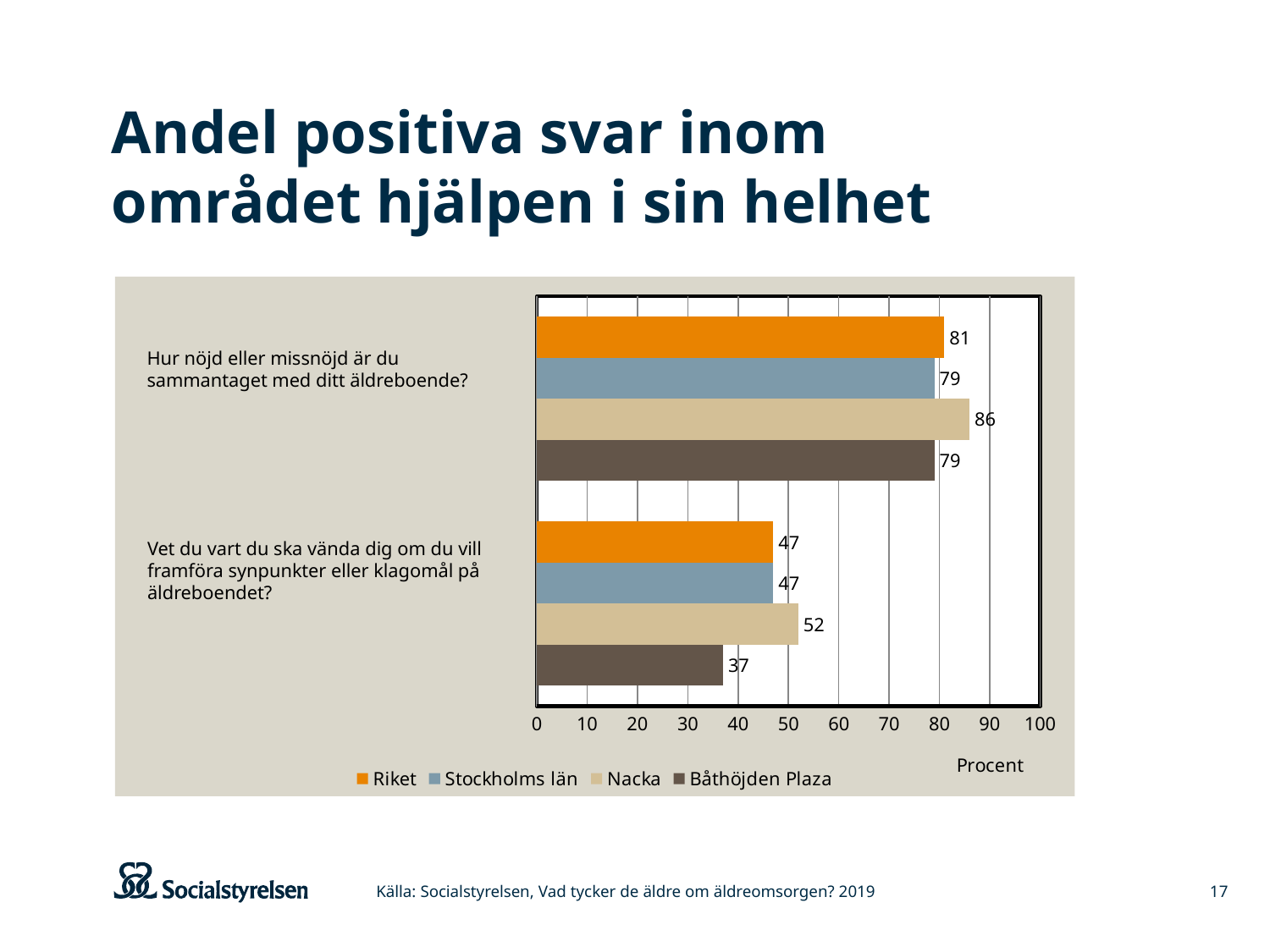
Which series has the lowest value on the question "Vet du vart du ska vända dig om du vill framföra synpunkter eller klagomål på äldreboendet?"? Båthöjden Plaza What is the value for Nacka on the question "Hur nöjd eller missnöjd är du sammantaget med ditt äldreboende?"? 86 How many series does the legend list? 4 What is the label of the horizontal axis? Procent What is the difference between the Nacka and Båthöjden Plaza values on the question "Hur nöjd eller missnöjd är du sammantaget med ditt äldreboende?"? 7 How many questions (categories) are shown on the chart? 2 What is the value for Riket on the question "Hur nöjd eller missnöjd är du sammantaget med ditt äldreboende?"? 81 Which is larger on the question "Vet du vart du ska vända dig om du vill framföra synpunkter eller klagomål på äldreboendet?": Riket or Båthöjden Plaza? Riket Which series has the highest value on the question "Vet du vart du ska vända dig om du vill framföra synpunkter eller klagomål på äldreboendet?"? Nacka What kind of chart is shown on the slide? Bar chart What is the value for Stockholms län on the question "Vet du vart du ska vända dig om du vill framföra synpunkter eller klagomål på äldreboendet?"? 47 What is the value for Båthöjden Plaza on the question "Vet du vart du ska vända dig om du vill framföra synpunkter eller klagomål på äldreboendet?"? 37